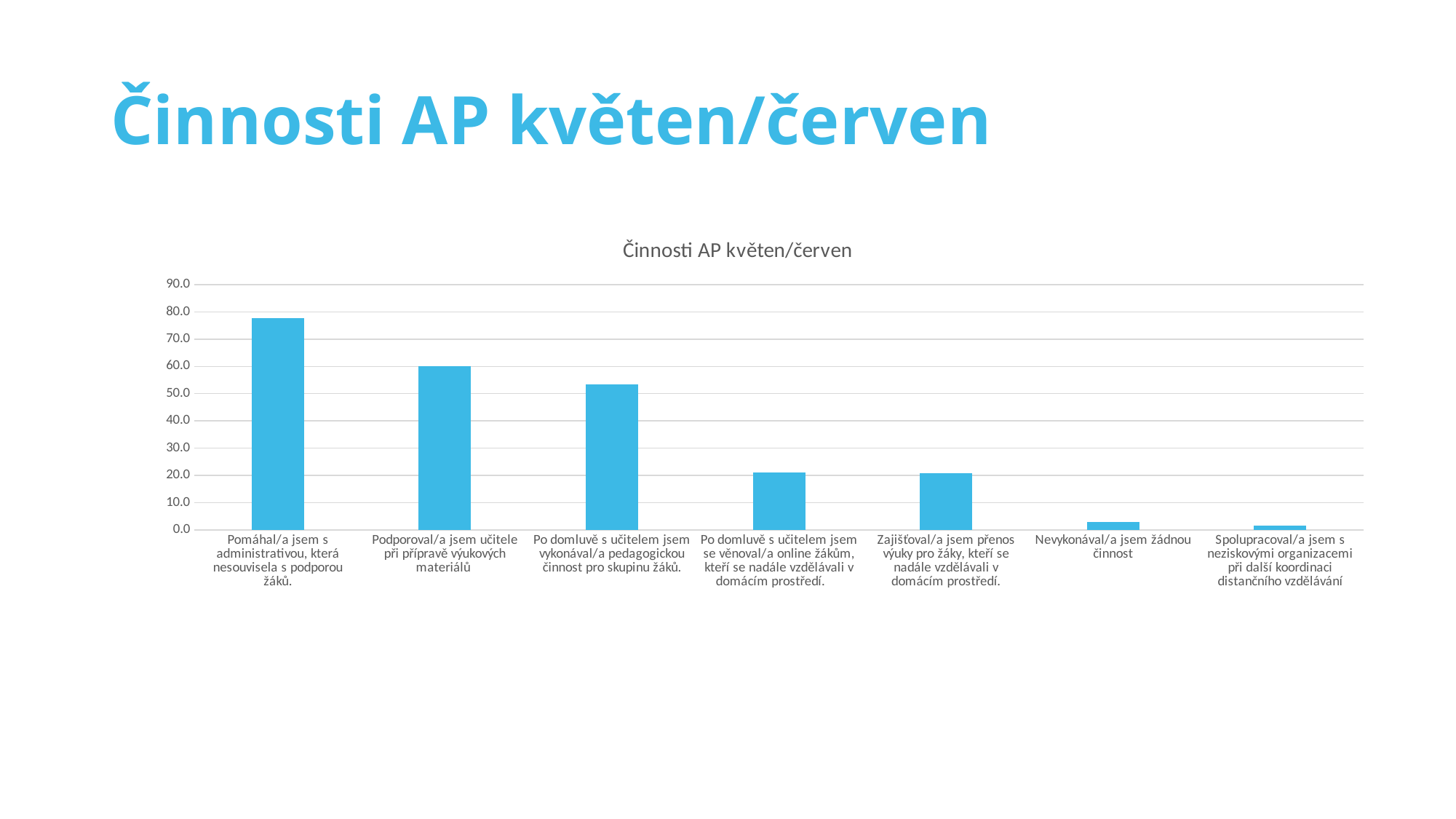
Which category has the highest value? Pomáhal/a jsem s administrativou, která nesouvisela s podporou žáků. Is the value for 'Pomáhal/a jsem s administrativou, která nesouvisela s podporou žáků.' greater or less than 70.0? greater Is the value for 'Po domluvě s učitelem jsem vykonával/a pedagogickou činnost pro skupinu žáků.' greater or less than 50.0? greater Do the values generally rise or fall from left to right along the x axis? fall Which is larger: the value for 'Podporoval/a jsem učitele při přípravě výukových materiálů' or the value for 'Po domluvě s učitelem jsem vykonával/a pedagogickou činnost pro skupinu žáků.'? Podporoval/a jsem učitele při přípravě výukových materiálů What is the highest value shown on the vertical axis? 90.0 What kind of chart is shown on the slide? bar chart How many categories are plotted in the chart? 7 What is the title of the chart? Činnosti AP květen/červen Which category has the lowest value? Spolupracoval/a jsem s neziskovými organizacemi při další koordinaci distančního vzdělávání Is the value for 'Nevykonával/a jsem žádnou činnost' greater or less than 10.0? less